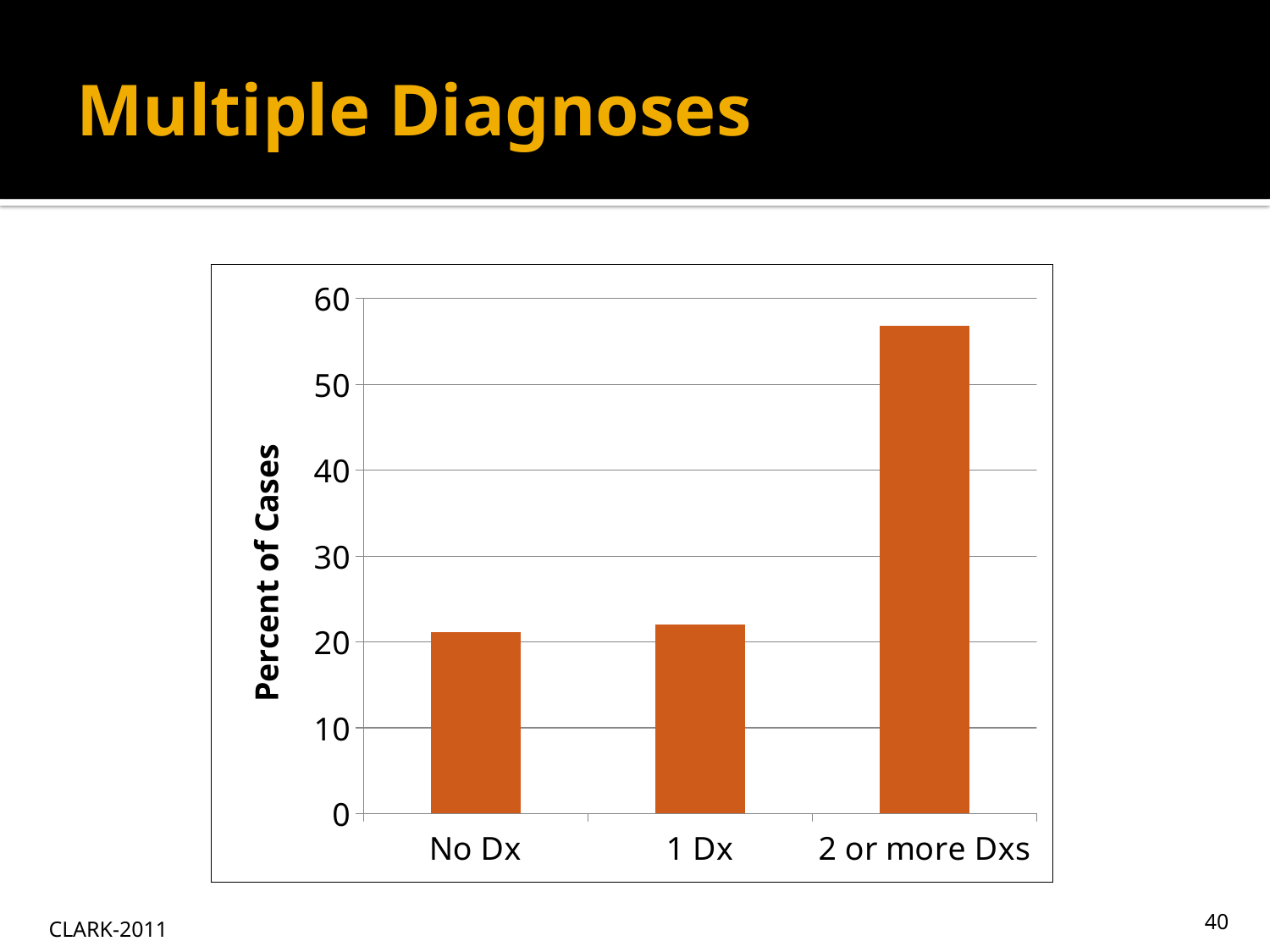
Is the value for 2 or more Dxs greater or less than 60? less Is the value for No Dx greater or less than 30? less What kind of chart is shown on the slide? bar chart Do the values rise or fall from left to right along the x axis? rise How many categories are shown on the x axis of the chart? 3 Is the value for 2 or more Dxs greater or less than 50? greater What is the label of the vertical axis of the chart? Percent of Cases What is the title of the slide containing the chart? Multiple Diagnoses Which category has the highest percent of cases? 2 or more Dxs Which is larger, the value for 1 Dx or the value for 2 or more Dxs? 2 or more Dxs Which is larger, the value for 2 or more Dxs or the value for No Dx? 2 or more Dxs